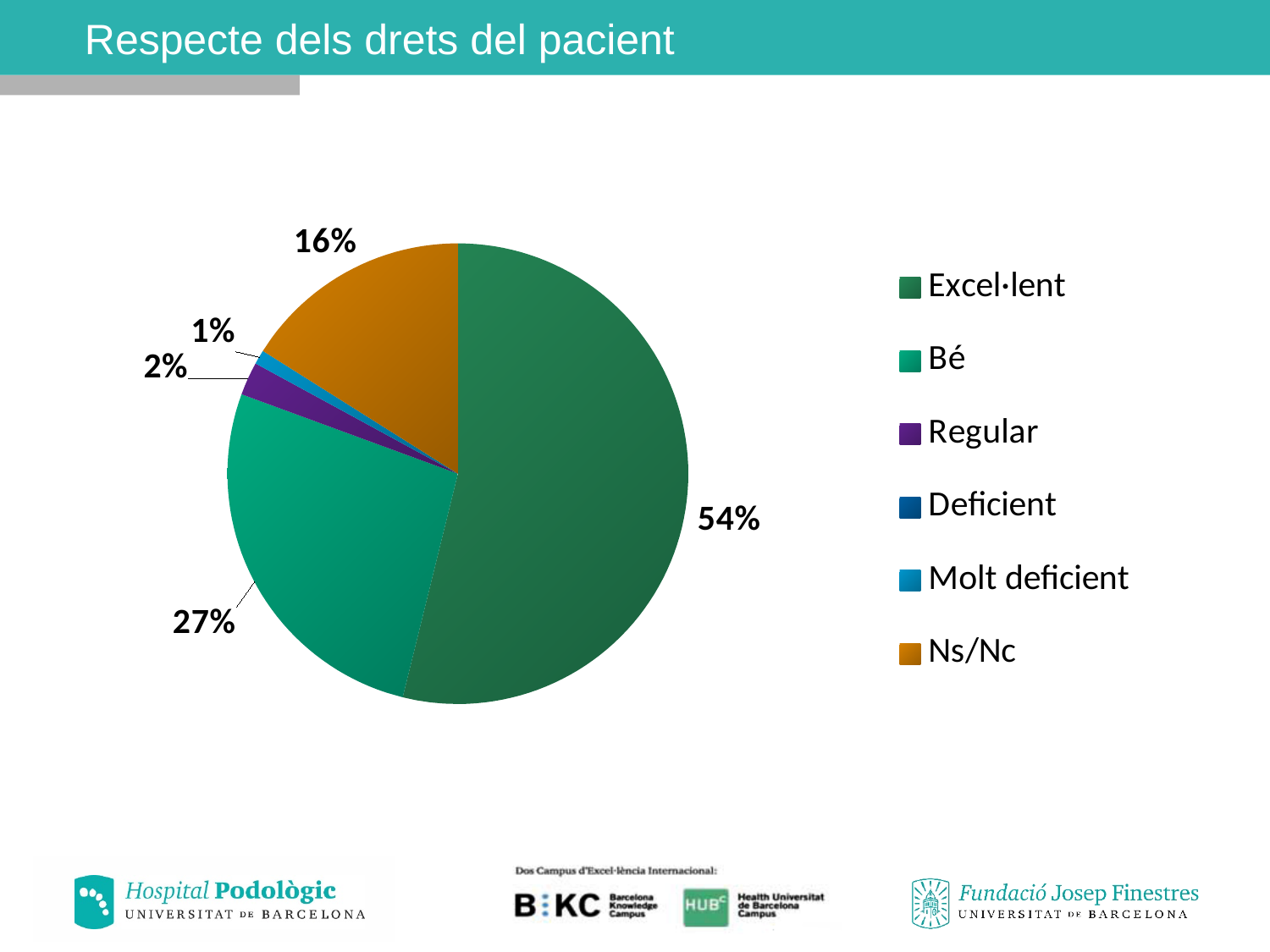
Which category has the largest slice of the pie chart? Excel·lent How many entries does the legend of the chart list? 6 What is the title of the slide containing the chart? Respecte dels drets del pacient What percentage is shown for Molt deficient in the pie chart? 1% What percentage of the pie chart is labelled Excel·lent? 54% Which labelled category has the smallest slice of the pie chart? Molt deficient What type of chart is shown on the slide? Pie chart What is the difference in percentage points between Excel·lent and Bé? 27 What percentage is shown for Regular in the pie chart? 2% What share of the pie chart does Bé represent? 27% What percentage is shown for Ns/Nc in the pie chart? 16% Which is larger, the share for Bé or the share for Ns/Nc? Bé